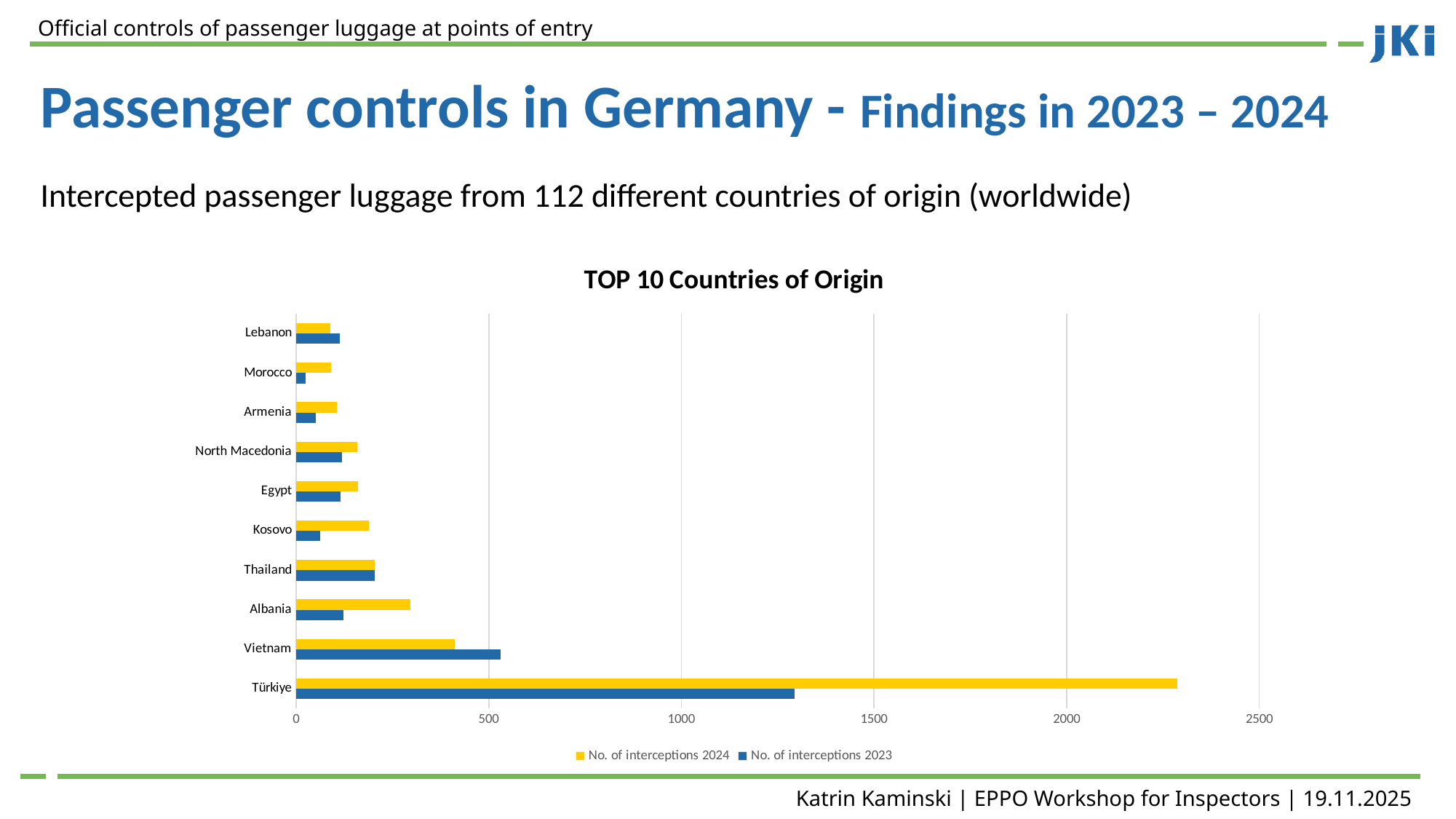
What is the title of the chart? TOP 10 Countries of Origin Which country has the highest number of interceptions in 2024? Türkiye Which country has the highest number of interceptions in 2023? Türkiye Is the number of interceptions for Türkiye in 2024 greater or less than 2000? greater Is the number of interceptions for Türkiye in 2023 greater or less than 1000? greater How many countries are shown in the chart? 10 How many series does the legend list? 2 Is the number of interceptions for Vietnam in 2024 greater or less than 500? less Which country has the lowest number of interceptions in 2023? Morocco What kind of chart is shown on the slide? Bar chart For Albania, which year had more interceptions, 2023 or 2024? 2024 For Vietnam, which year had more interceptions, 2023 or 2024? 2023